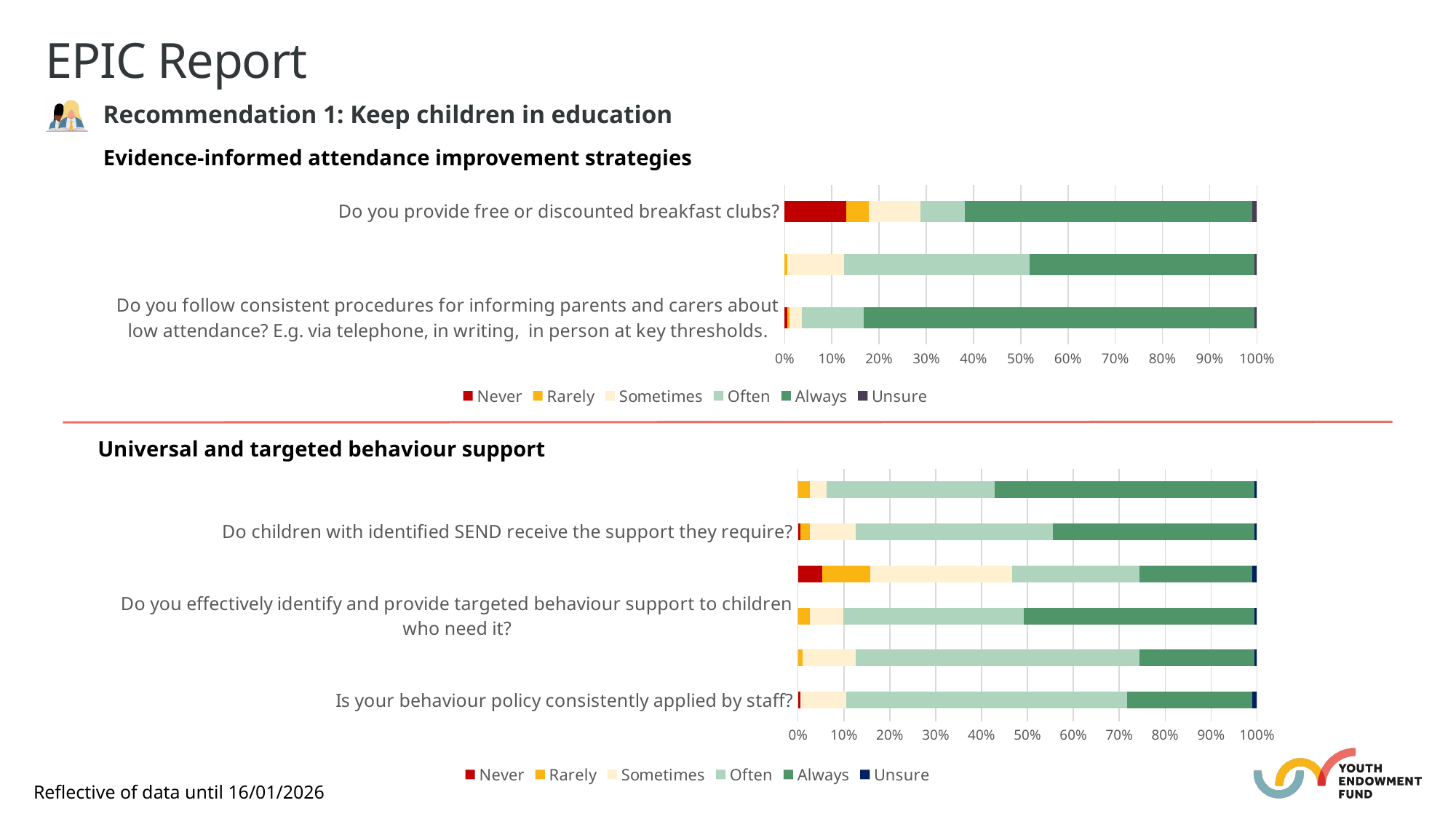
What colour represents the 'Never' response in the legends on the slide? Red In the 'Evidence-informed attendance improvement strategies' chart, for 'Do you provide free or discounted breakfast clubs?', which is larger: the 'Always' share or the 'Often' share? Always What is the title of the lower chart on the slide? Universal and targeted behaviour support How many series does the legend of the 'Universal and targeted behaviour support' chart list? 6 How many bars are plotted in the 'Universal and targeted behaviour support' chart? 6 In the 'Evidence-informed attendance improvement strategies' chart, is the 'Never' share for 'Do you provide free or discounted breakfast clubs?' greater or less than 20%? less In the 'Universal and targeted behaviour support' chart, is the 'Often' share for 'Is your behaviour policy consistently applied by staff?' greater or less than 50%? greater How many bars are plotted in the 'Evidence-informed attendance improvement strategies' chart? 3 In the 'Universal and targeted behaviour support' chart, for 'Is your behaviour policy consistently applied by staff?', which is larger: the 'Often' share or the 'Always' share? Often What kind of chart is the 'Evidence-informed attendance improvement strategies' chart? Stacked bar chart In the 'Evidence-informed attendance improvement strategies' chart, which response category takes the largest share of the bar for 'Do you provide free or discounted breakfast clubs?'? Always In the 'Evidence-informed attendance improvement strategies' chart, is the 'Always' share for 'Do you follow consistent procedures for informing parents and carers about low attendance?' greater or less than 70%? greater